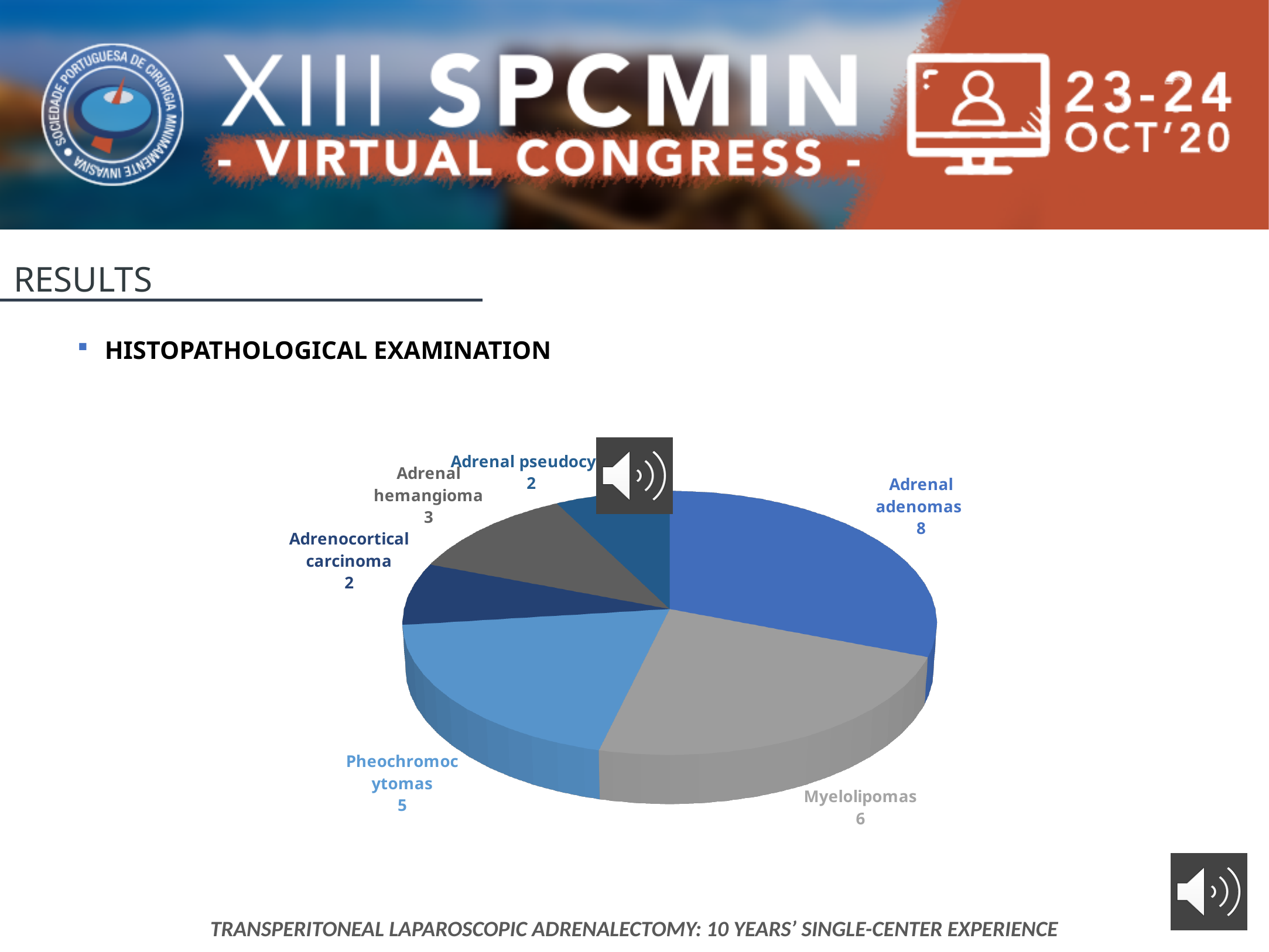
What is the heading of the bullet point above the pie chart? HISTOPATHOLOGICAL EXAMINATION What is the value for Myelolipomas in the pie chart? 6 What is the difference between the values for Adrenal adenomas and Myelolipomas? 2 What is the value for Adrenocortical carcinoma in the pie chart? 2 What type of chart is shown on the slide? Pie chart Which category has the largest slice in the pie chart? Adrenal adenomas What is the value for Adrenal hemangioma in the pie chart? 3 How many slices does the pie chart have? 6 How many cases of Adrenal adenomas are shown in the pie chart? 8 What is the difference between the values for Pheochromocytomas and Adrenocortical carcinoma? 3 Which is larger, the value for Myelolipomas or the value for Pheochromocytomas? Myelolipomas What is the value for Pheochromocytomas in the pie chart? 5